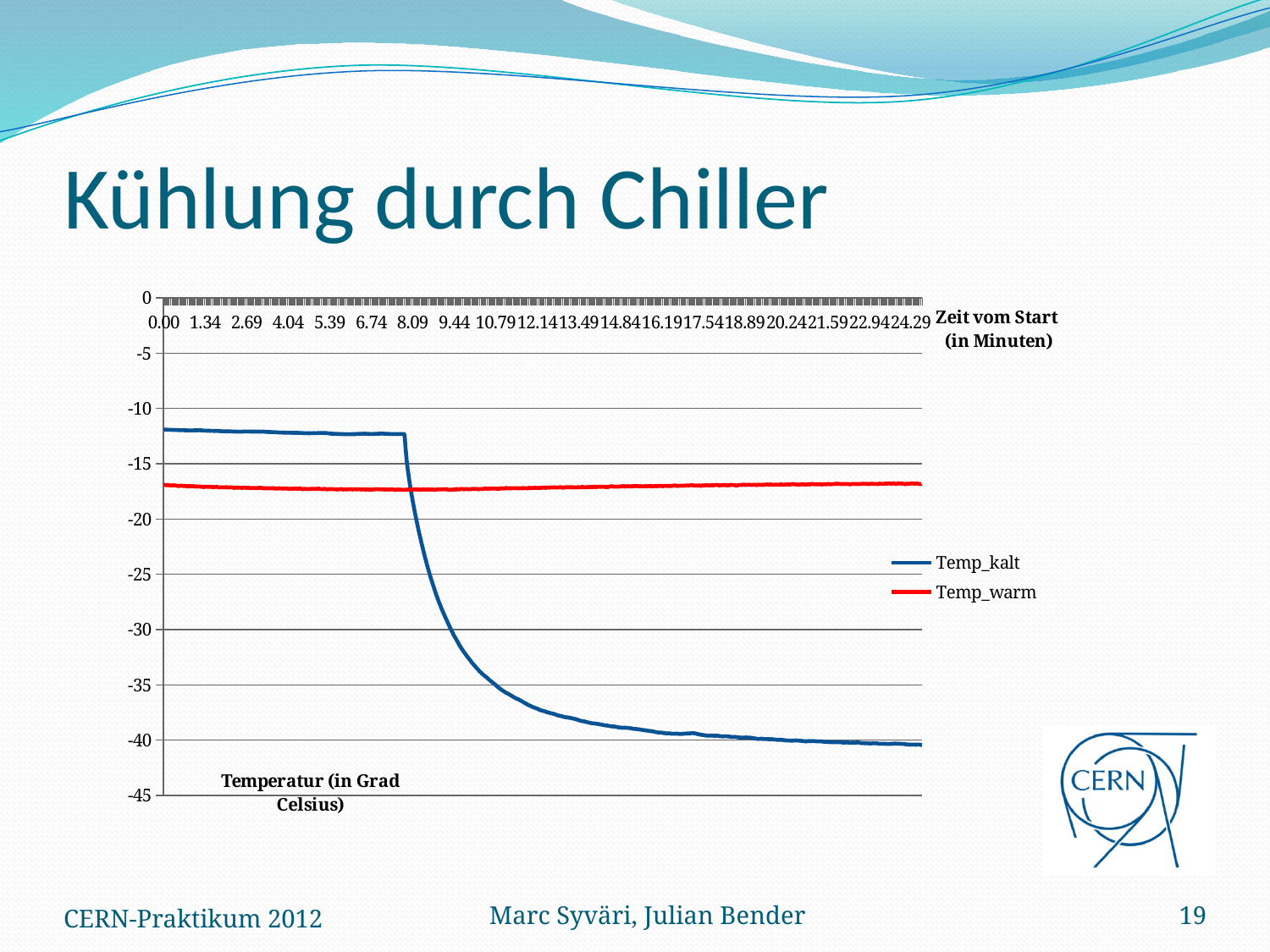
Is the value of Temp_warm at time 12.14 greater or less than -20? greater Is the value of Temp_warm at time 5.39 greater or less than -15? less At time 0.00, which series has the higher temperature, Temp_kalt or Temp_warm? Temp_kalt What kind of chart is shown on the slide? line chart What are the two series named in the legend? Temp_kalt and Temp_warm Is the value of Temp_kalt at time 0.00 greater or less than -15? greater At time 24.29, which series has the higher temperature, Temp_kalt or Temp_warm? Temp_warm Does the Temp_kalt series rise or fall along the x axis overall? fall How many series does the legend list? 2 What is the title of the chart on the slide? Kühlung durch Chiller